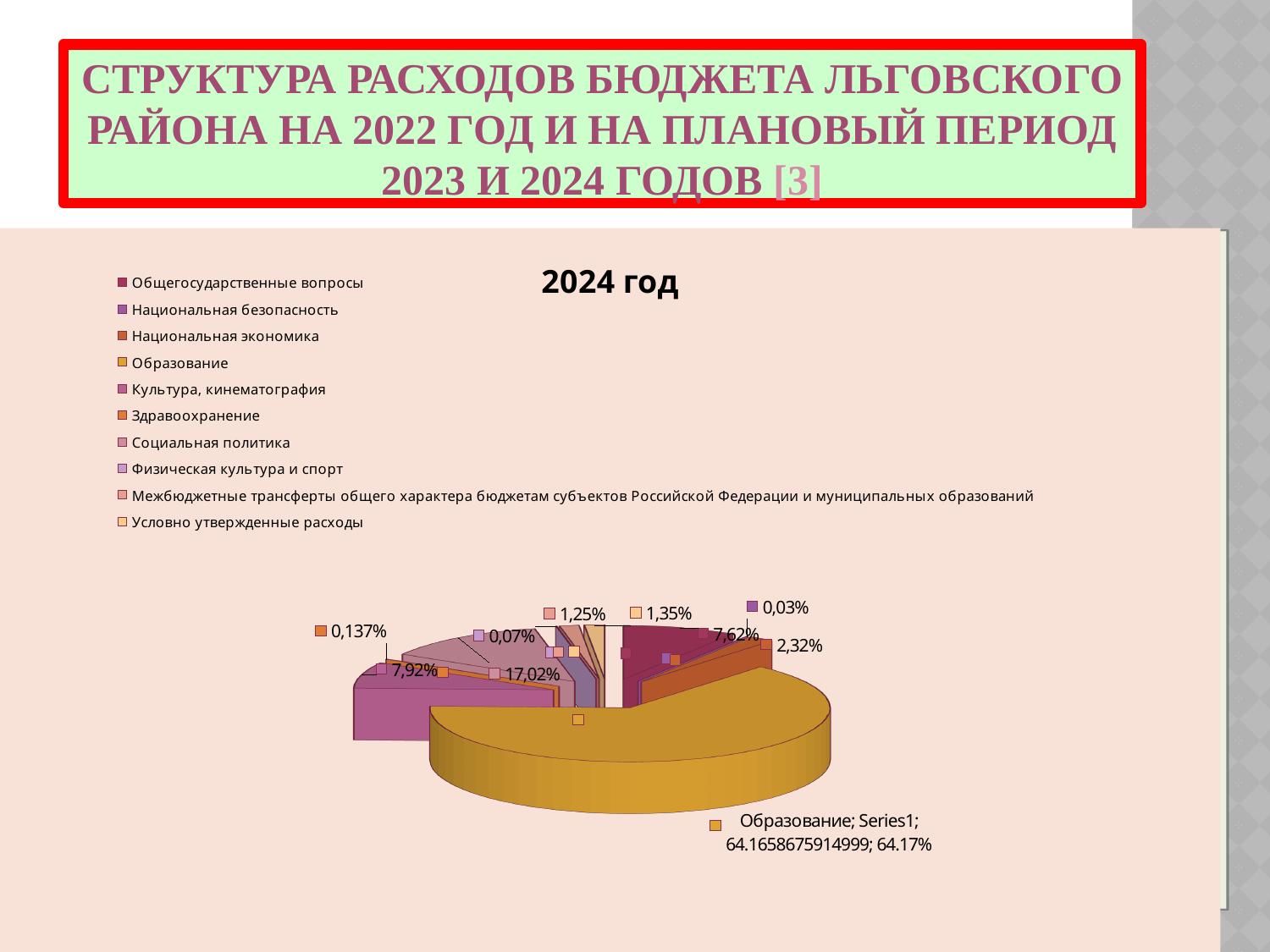
Is the share for Образование greater or less than 50%? greater How many data labels on the pie chart show values below 1%? 3 What is the title of the pie chart? 2024 год What is the largest percentage value printed as a data label on the pie chart? 64.17% Does Образование account for more or less than half of the pie? more What share of the pie does Образование have? 64.17% What is the smallest percentage value printed as a data label on the pie chart? 0,03% Which category has the largest slice of the pie? Образование How many categories does the legend of the pie chart list? 10 What kind of chart is shown on the slide? pie chart Which category is listed first in the legend of the pie chart? Общегосударственные вопросы